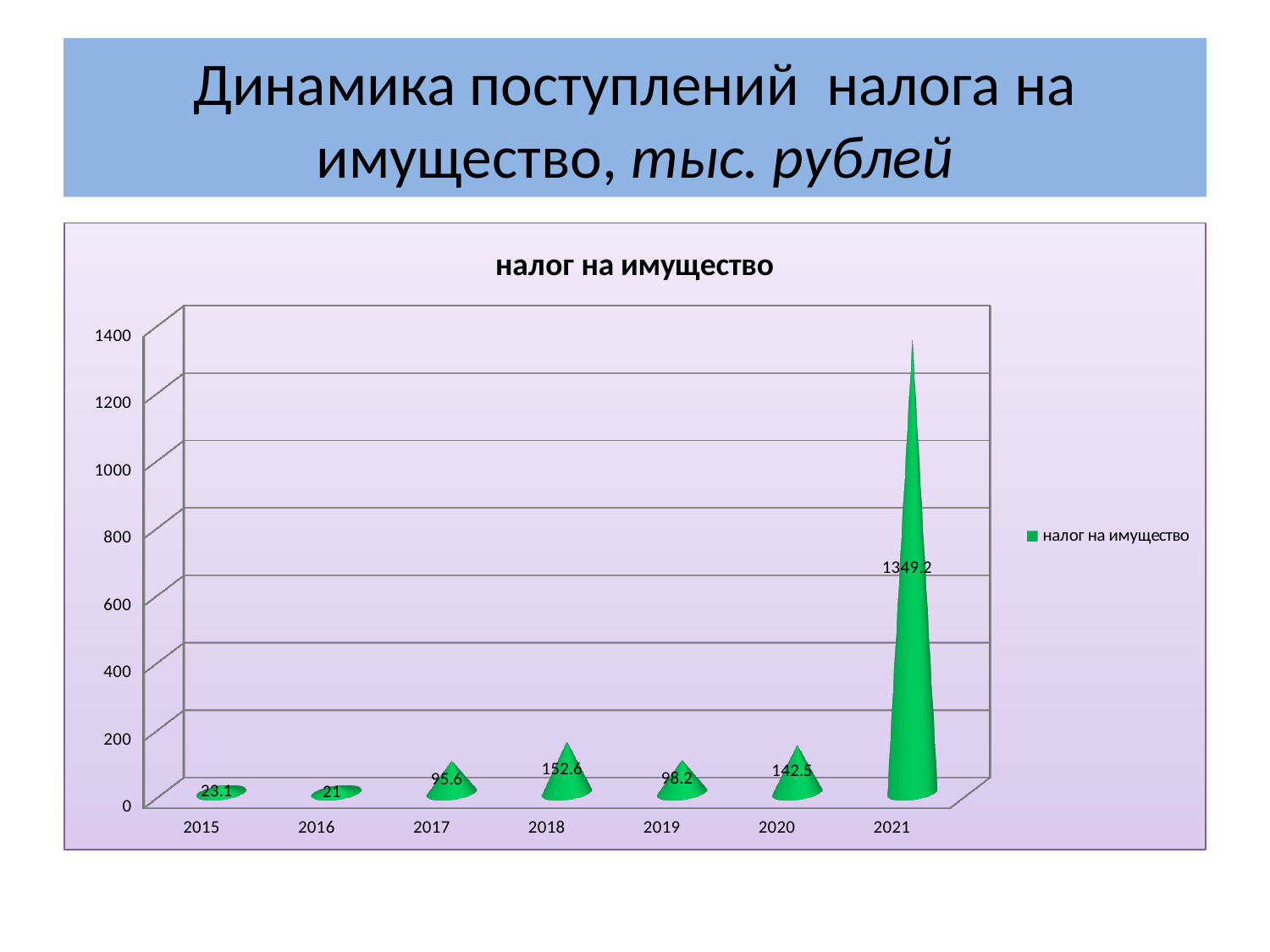
How many series does the legend list? 1 What is the difference between the values for 2018 and 2017? 57 What kind of chart is shown on the slide? bar chart What is the value for 2018 in the chart? 152.6 How many years are shown on the x axis of the chart? 7 Which year has the lowest value in the chart? 2016 Which is larger, the value for 2019 or the value for 2020? 2020 What is the value for 2016 in the chart? 21 Is the value for 2021 greater or less than 1200? greater What is the title of the chart? налог на имущество What is the value for 2021 in the chart? 1349.2 Which year has the highest value in the chart? 2021